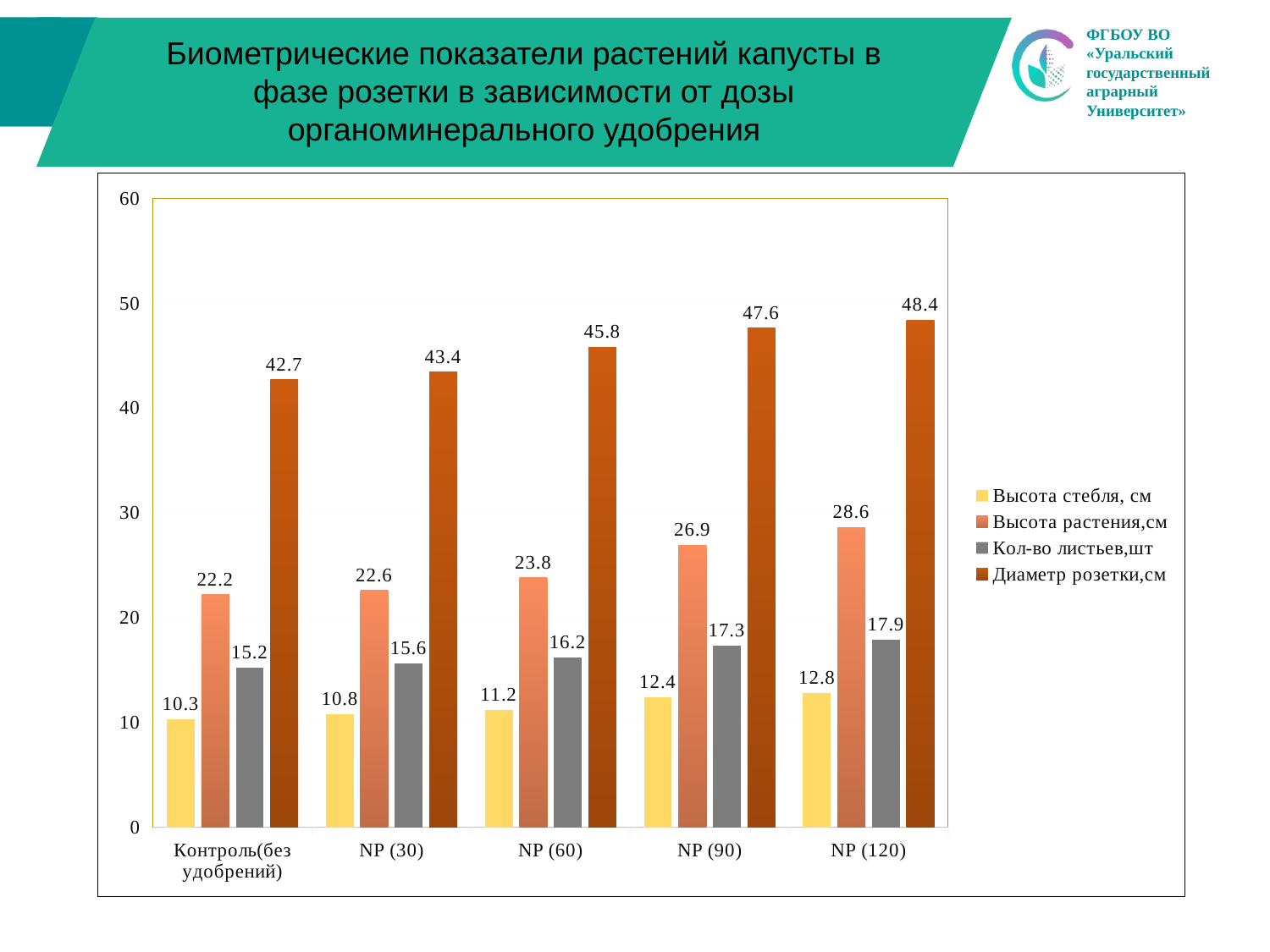
How many categories are shown on the x axis? 5 What is the value of Высота растения,см for NP (90)? 26.9 Which is larger: Высота растения,см for NP (30) or Кол-во листьев,шт for NP (120)? Высота растения,см for NP (30) Is the value of Диаметр розетки,см for NP (60) greater or less than 40? greater What is the value of Диаметр розетки,см for NP (120)? 48.4 What is the value of Высота стебля, см for Контроль(без удобрений)? 10.3 Which category has the highest value for Диаметр розетки,см? NP (120) What is the difference between Диаметр розетки,см for NP (120) and for Контроль(без удобрений)? 5.7 How many series does the legend list? 4 Does Высота стебля, см rise or fall from Контроль(без удобрений) to NP (120)? rise Which category has the lowest value for Высота растения,см? Контроль(без удобрений) What is the value of Кол-во листьев,шт for NP (60)? 16.2